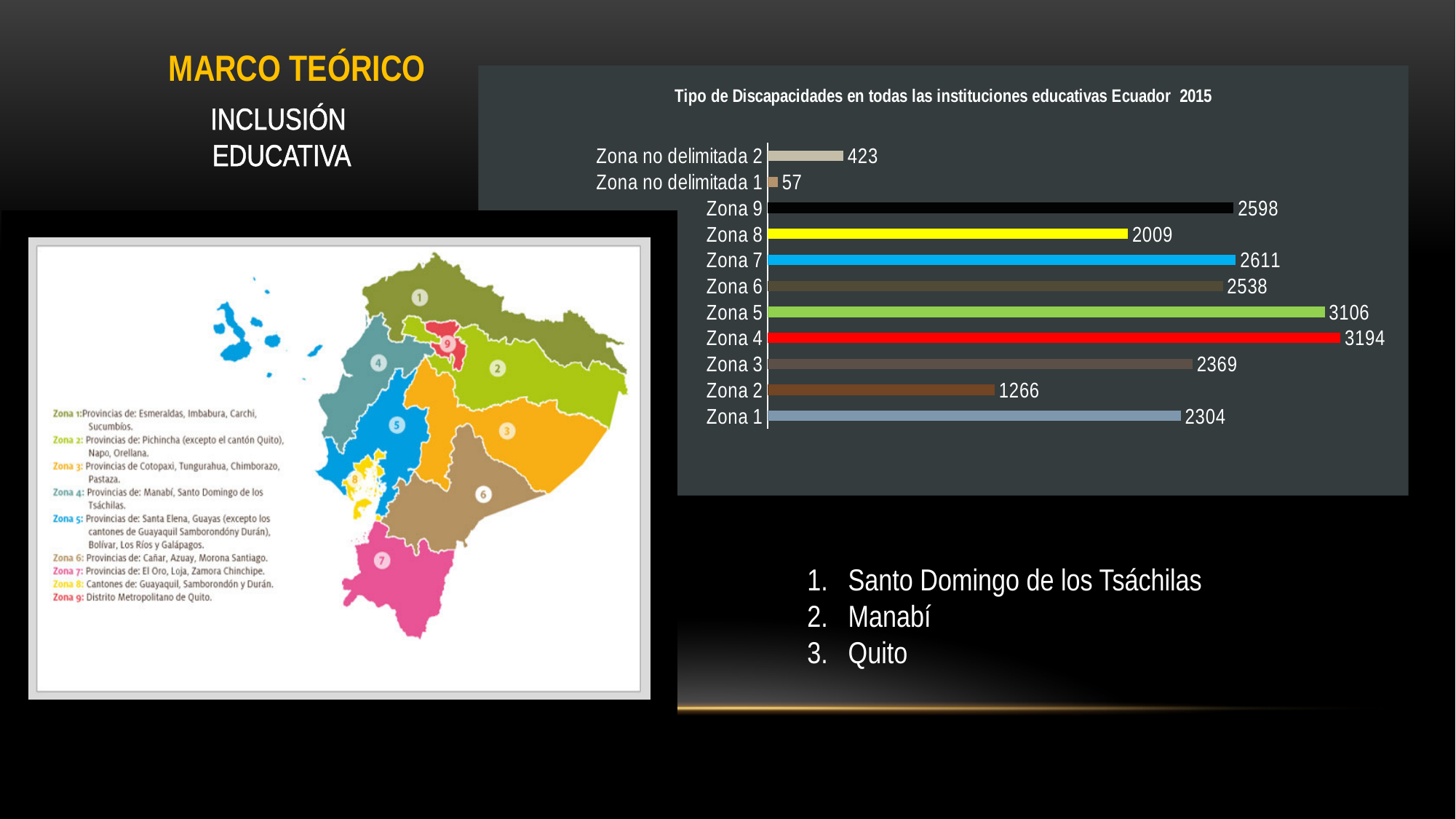
What is the difference between the values for Zona 7 and Zona 2? 1345 What is the value for Zona no delimitada 2? 423 What is the difference between the values for Zona 4 and Zona 5? 88 Which is larger, the value for Zona 9 or the value for Zona 3? Zona 9 Which category has the lowest value? Zona no delimitada 1 How many categories are shown in the bar chart? 11 What is the title of the chart? Tipo de Discapacidades en todas las instituciones educativas Ecuador 2015 What is the value for Zona 4? 3194 What is the value for Zona 8? 2009 Which zone has the highest value? Zona 4 What kind of chart is shown on the slide? bar chart What colour is the bar for Zona 8? yellow